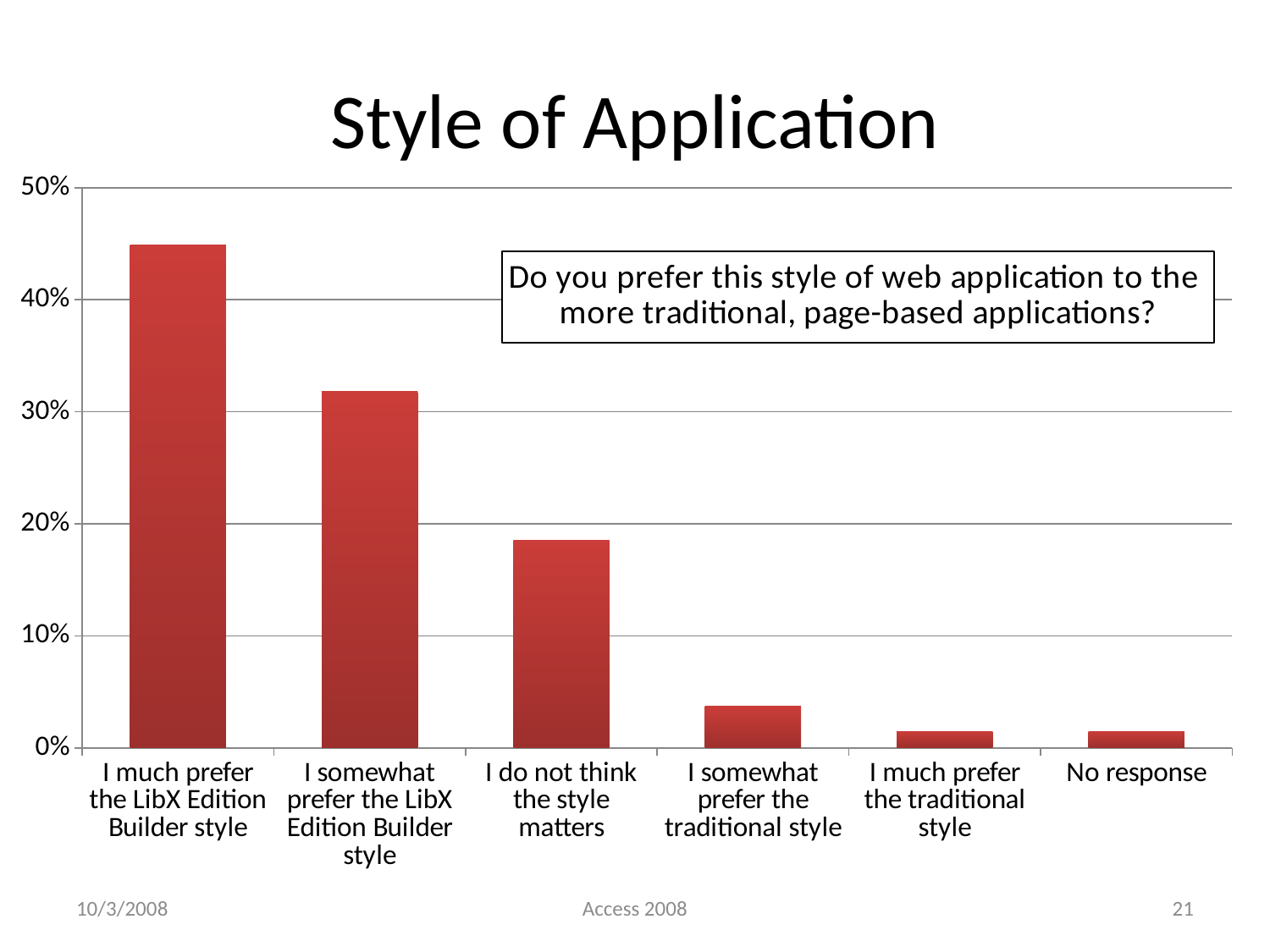
Which is larger, the value for "I somewhat prefer the traditional style" or the value for "No response"? I somewhat prefer the traditional style Which is larger, the value for "I somewhat prefer the LibX Edition Builder style" or the value for "I do not think the style matters"? I somewhat prefer the LibX Edition Builder style How many response categories are shown on the x axis? 6 What is the title of the chart? Do you prefer this style of web application to the more traditional, page-based applications? Which response category has the highest value? I much prefer the LibX Edition Builder style What survey question is shown in the text box on the chart? Do you prefer this style of web application to the more traditional, page-based applications? What kind of chart is shown on the slide? bar chart Do the bar values generally rise or fall from left to right along the x axis? fall Is the value for "I somewhat prefer the traditional style" greater or less than 10%? less Is the value for "I somewhat prefer the LibX Edition Builder style" greater or less than 30%? greater Is the value for "I much prefer the LibX Edition Builder style" greater or less than 40%? greater